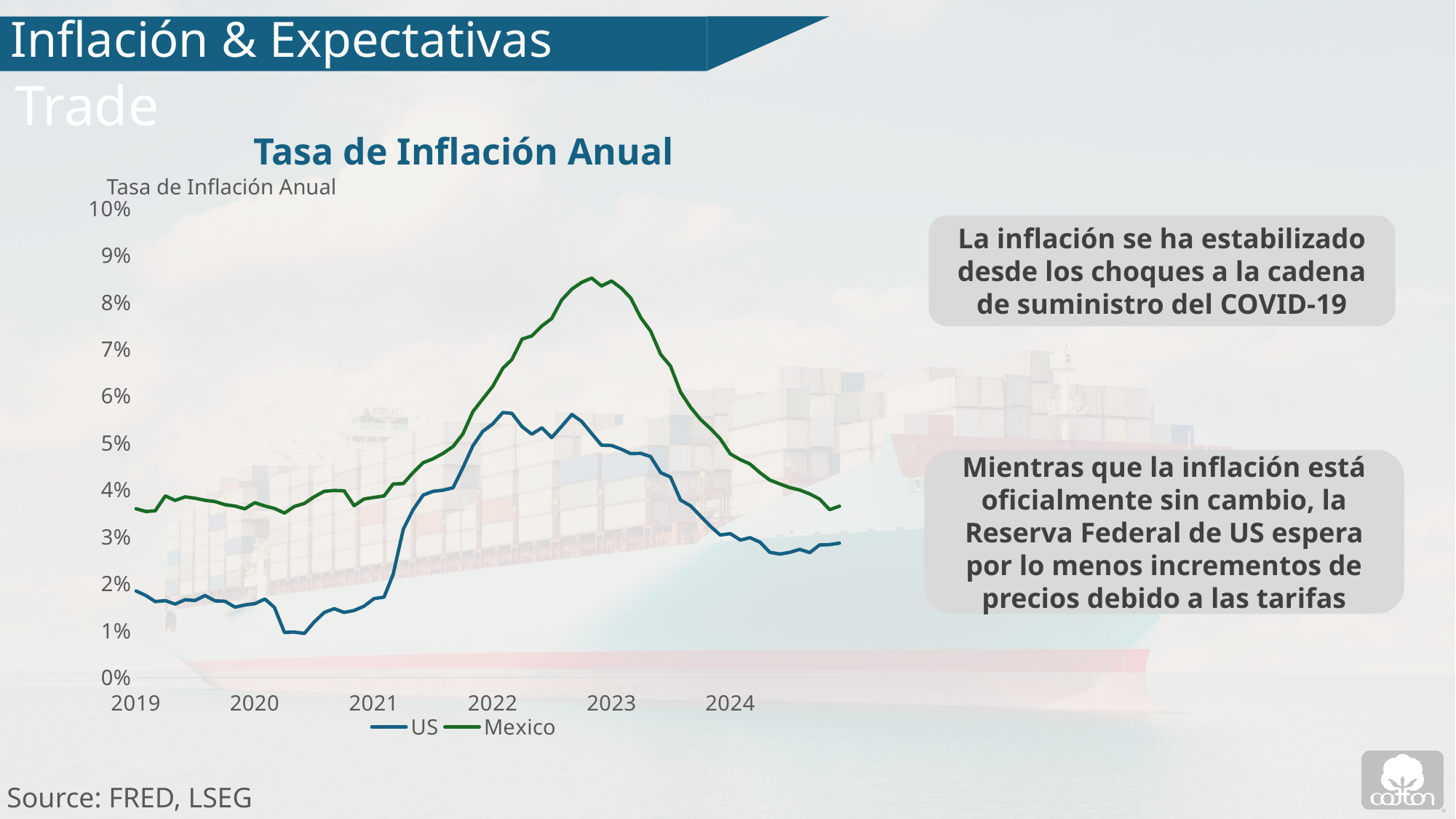
Is the peak value for Mexico around 2023 greater or less than 8%? greater Is the value for US at the end of the series greater or less than 4%? less At the start of 2023, which series has the higher inflation rate, US or Mexico? Mexico Which series reaches the highest inflation rate on the chart? Mexico Is the value for Mexico at the start of 2019 greater or less than 4%? less Does the US inflation rate rise or fall between 2023 and 2024? fall How many series does the legend list? 2 What is the title of the chart? Tasa de Inflación Anual What kind of chart is shown on the slide? line chart How many year labels are shown on the x axis? 6 What are the two series named in the legend? US and Mexico